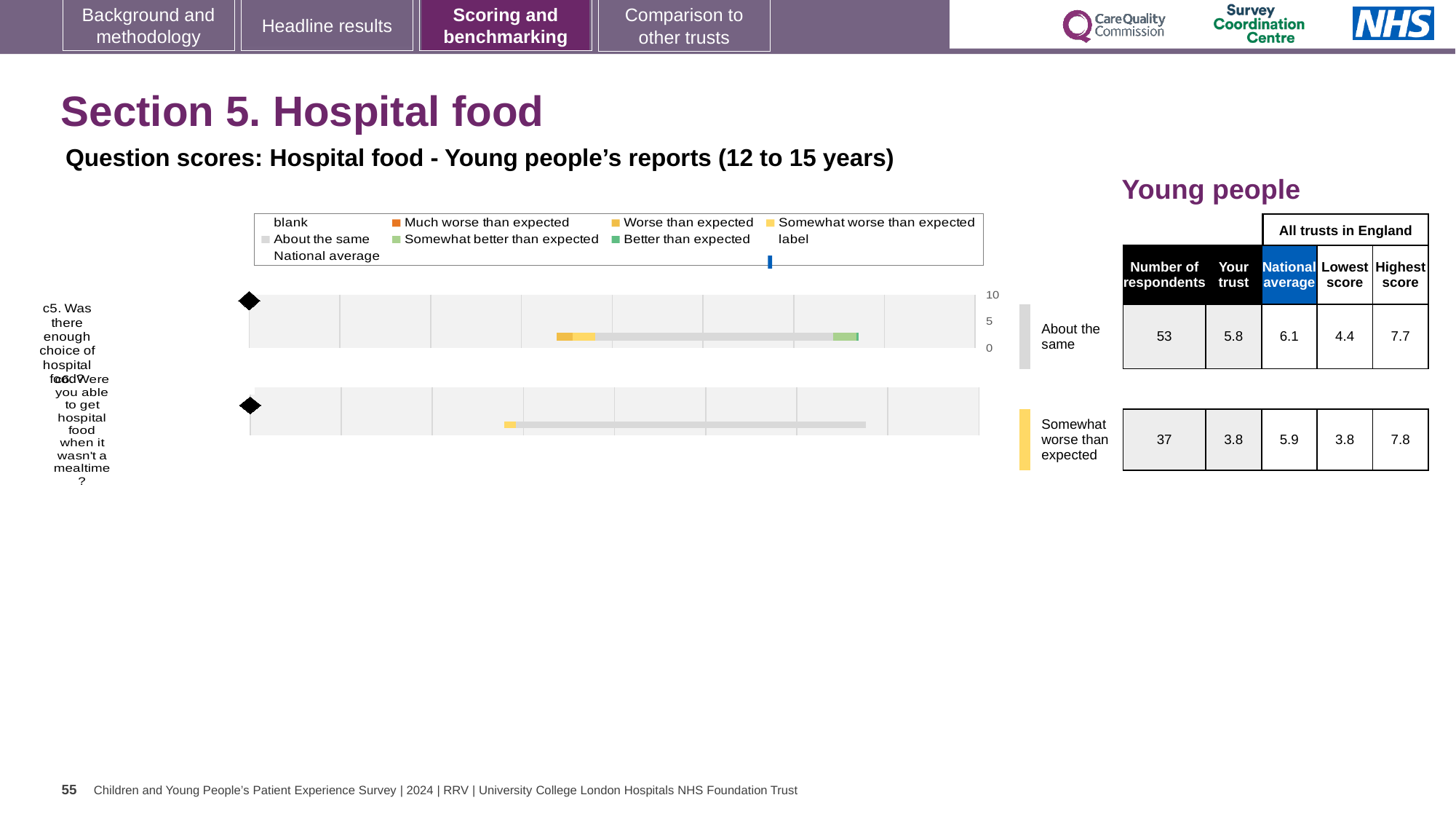
In the table beside the chart, which row has the higher 'Your trust' score: 'About the same' or 'Somewhat worse than expected'? About the same In the table beside the chart, what is the national average for the 'About the same' row? 6.1 In the table beside the chart, how many respondents answered the 'Somewhat worse than expected' question? 37 Which rating category is shown for question c6 (able to get hospital food when it wasn't a mealtime)? Somewhat worse than expected In the table beside the chart, what is the difference between the 'Your trust' scores of the two rows (5.8 and 3.8)? 2.0 In the table beside the chart, what is the 'Your trust' score for the 'About the same' row (c5)? 5.8 In the chart legend, what colour represents 'Much worse than expected'? orange In the table beside the chart, what is the 'Your trust' score for the 'Somewhat worse than expected' row (c6)? 3.8 What kind of chart is shown on the slide? bar chart What is the highest value shown on the chart's axis? 10 How many questions (categories) are plotted in the chart? 2 Which rating category is shown for question c5 (enough choice of hospital food)? About the same